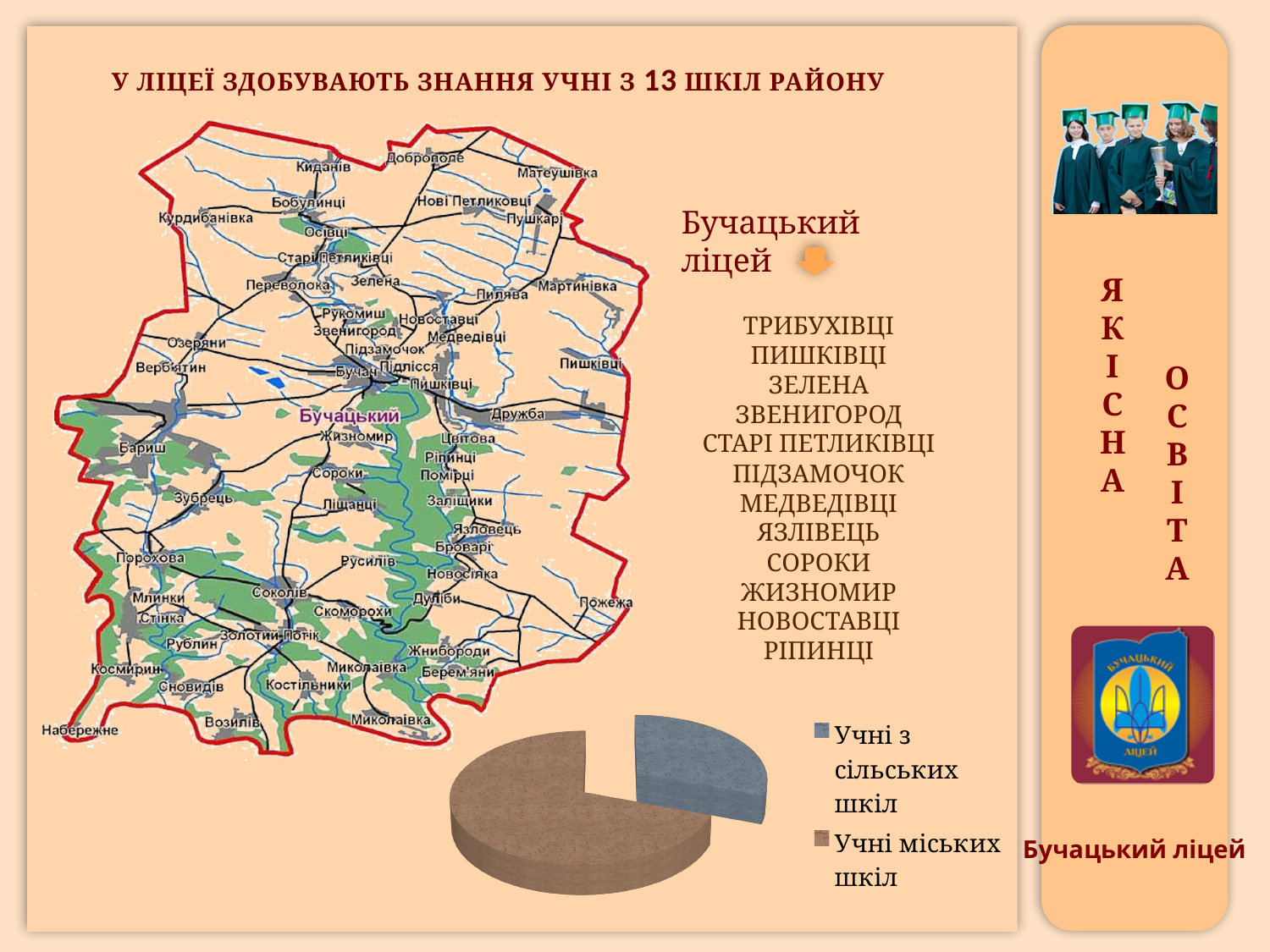
What colour is the slice for Учні міських шкіл in the pie chart? brown Which slice of the pie chart is the largest? Учні міських шкіл What kind of chart is shown at the bottom of the slide? pie chart How many entries does the pie chart's legend list? 2 In the pie chart, which is larger: the slice for Учні з сільських шкіл or the slice for Учні міських шкіл? Учні міських шкіл What colour is the slice for Учні з сільських шкіл in the pie chart? blue-grey Which slice of the pie chart is the smallest? Учні з сільських шкіл How many slices does the pie chart have? 2 Does the slice for Учні міських шкіл take up more or less than half of the pie chart? more